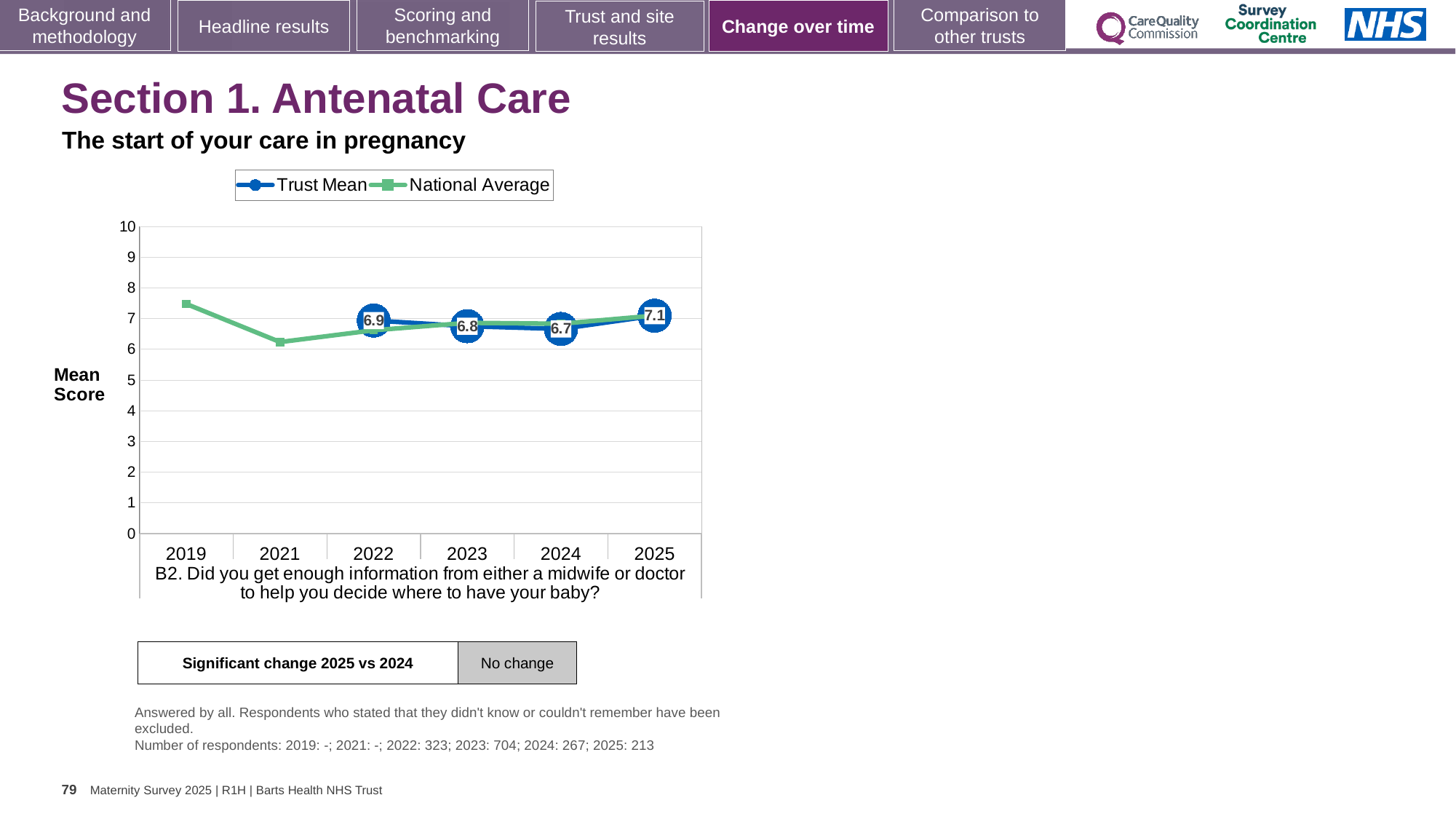
By how much did the Trust Mean increase from 2024 to 2025? 0.4 What is the Trust Mean score for 2024? 6.7 In which year is the Trust Mean lowest? 2024 Between 2022 and 2024, does the Trust Mean rise or fall? Fall What is the Trust Mean score for 2022? 6.9 Is the National Average for 2019 greater or less than 7? greater What is the Trust Mean score for 2025? 7.1 Which year has the higher Trust Mean, 2022 or 2023? 2022 How many series does the legend list? 2 Is the National Average for 2021 greater or less than 7? less In which year is the Trust Mean highest? 2025 What kind of chart is shown on the slide? Line chart